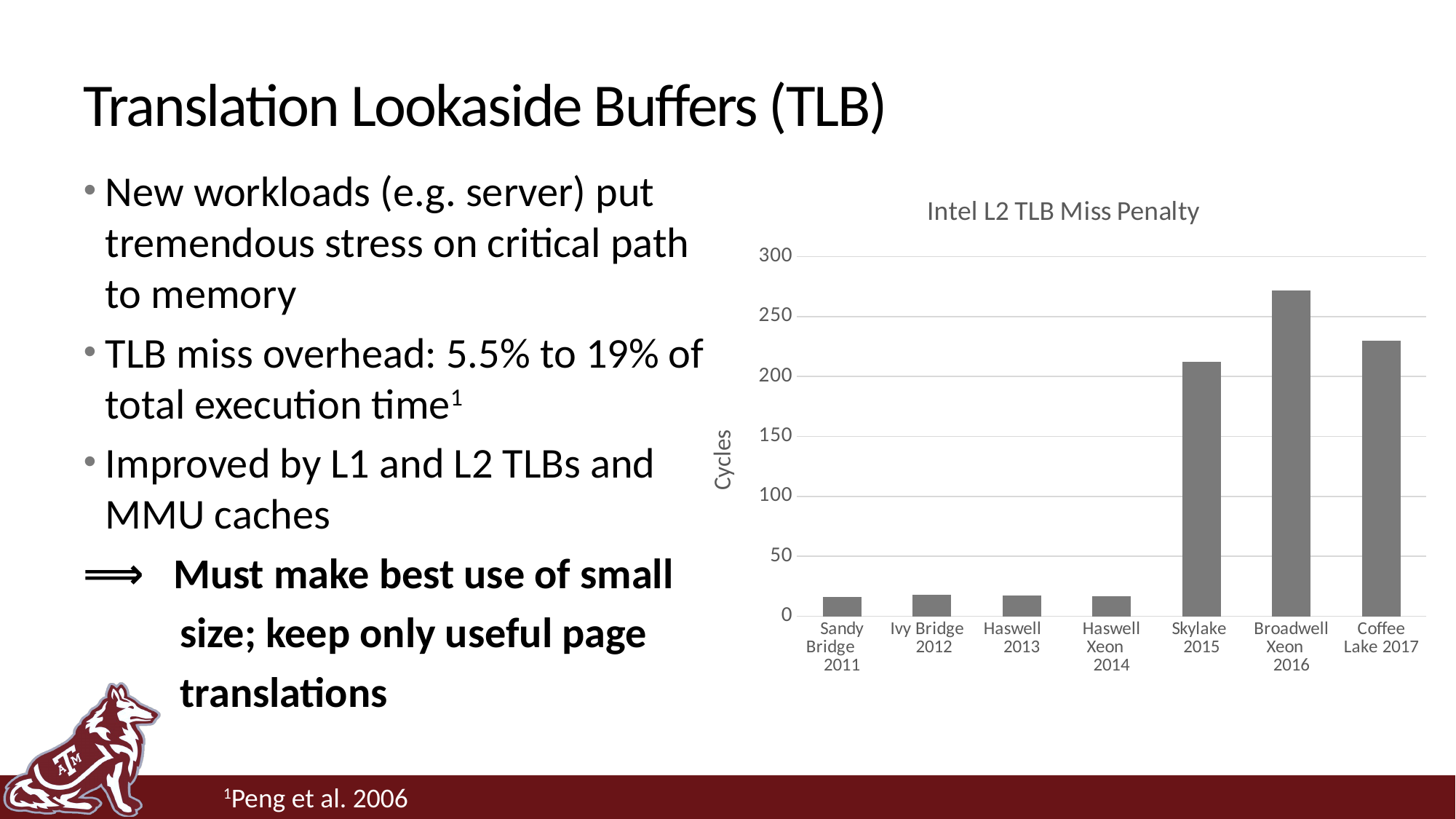
Is the value for Sandy Bridge 2011 greater or less than 50? less Which has a larger L2 TLB miss penalty, Broadwell Xeon 2016 or Coffee Lake 2017? Broadwell Xeon 2016 Is the value for Coffee Lake 2017 greater or less than 250? less How many processor categories are plotted in the chart? 7 Which processor has the highest L2 TLB miss penalty? Broadwell Xeon 2016 Is the value for Skylake 2015 greater or less than 200? greater What type of chart is shown on the slide? bar chart Do the L2 TLB miss penalty values generally rise or fall from left to right across the processor generations? rise What is the label on the vertical axis of the chart? Cycles What is the title of the chart? Intel L2 TLB Miss Penalty Which has a larger L2 TLB miss penalty, Haswell 2013 or Skylake 2015? Skylake 2015